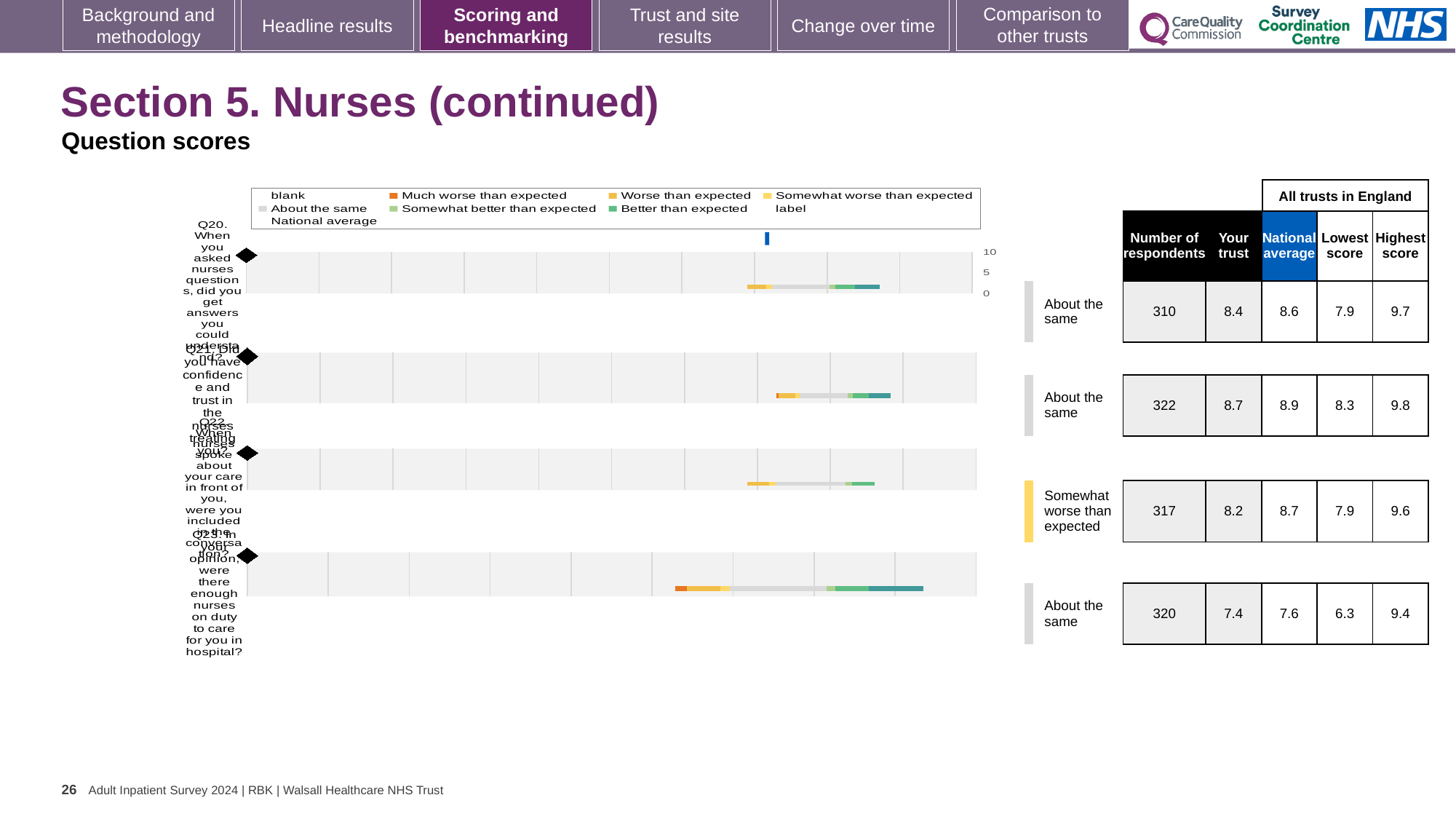
In the table beside the chart, what is the 'Your trust' score for Q20? 8.4 What is the difference between the national average and the 'Your trust' score for Q23? 0.2 How many questions (bars) are plotted in the chart? 4 What kind of chart is used to show the question scores on this slide? bar chart What is the highest score across all trusts in England for Q21? 9.8 In the table beside the chart, what is the national average for Q23? 7.6 What is the highest value shown on the chart's score axis? 10 Which question has the highest number of respondents in the table beside the chart? Q21 Which legend entry is shown in dark orange in the chart's legend? Much worse than expected Which question has the lowest 'Your trust' score in the table beside the chart? Q23 In the table beside the chart, how many respondents answered Q22? 317 Which has the higher 'Your trust' score, Q20 or Q21? Q21